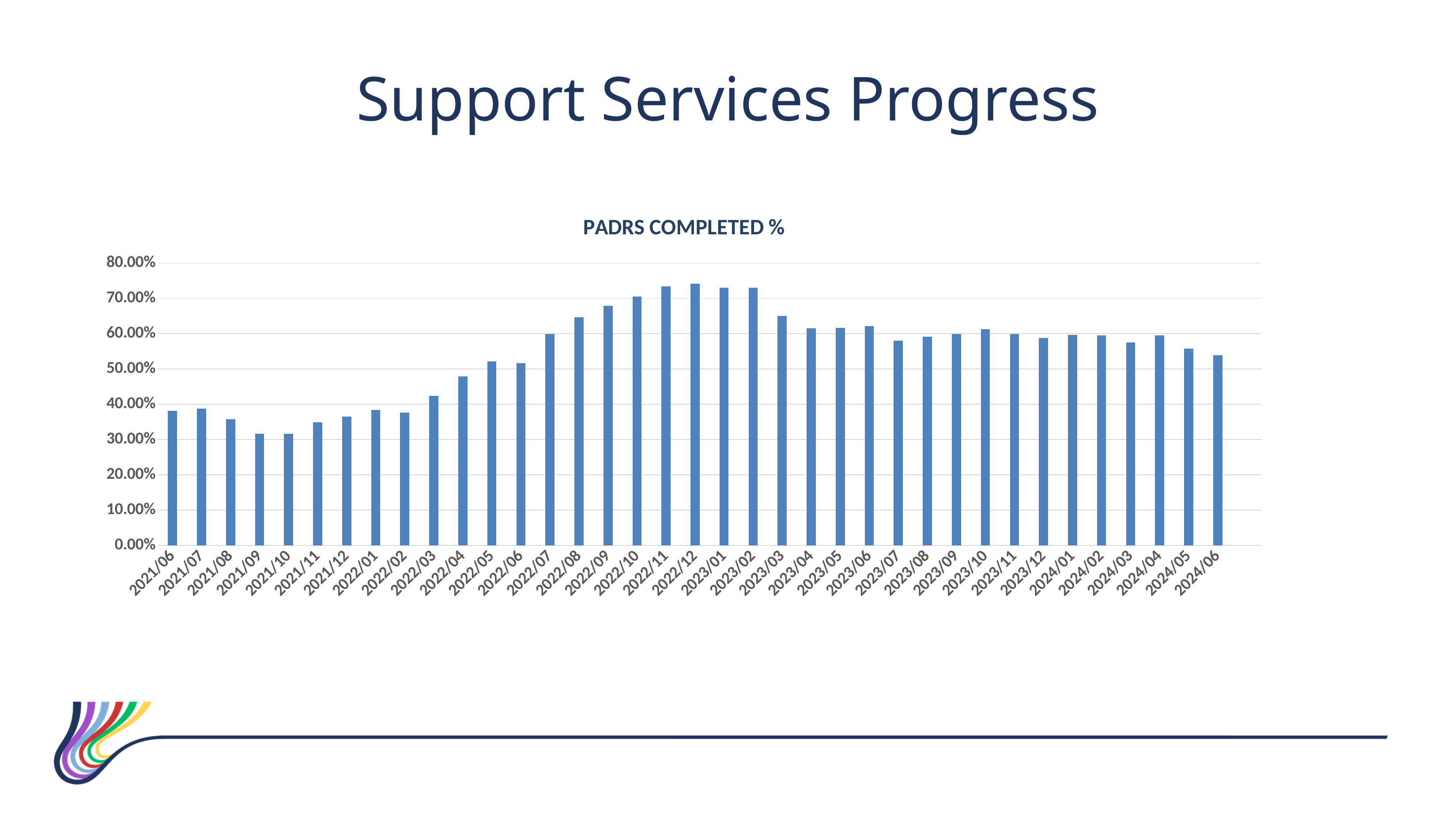
Is the value for 2021/06 greater or less than 40.00%? less Is the value for 2023/07 greater or less than 60.00%? less Is the value for 2022/04 greater or less than 50.00%? less Which is larger, the value for 2023/03 or the value for 2024/06? 2023/03 Do the values rise or fall from 2021/10 to 2022/12? rise How many months are plotted on the x axis of the chart? 37 What is the title of the chart? PADRS COMPLETED % What kind of chart is shown on the slide? Bar chart Which is larger, the value for 2022/12 or the value for 2021/06? 2022/12